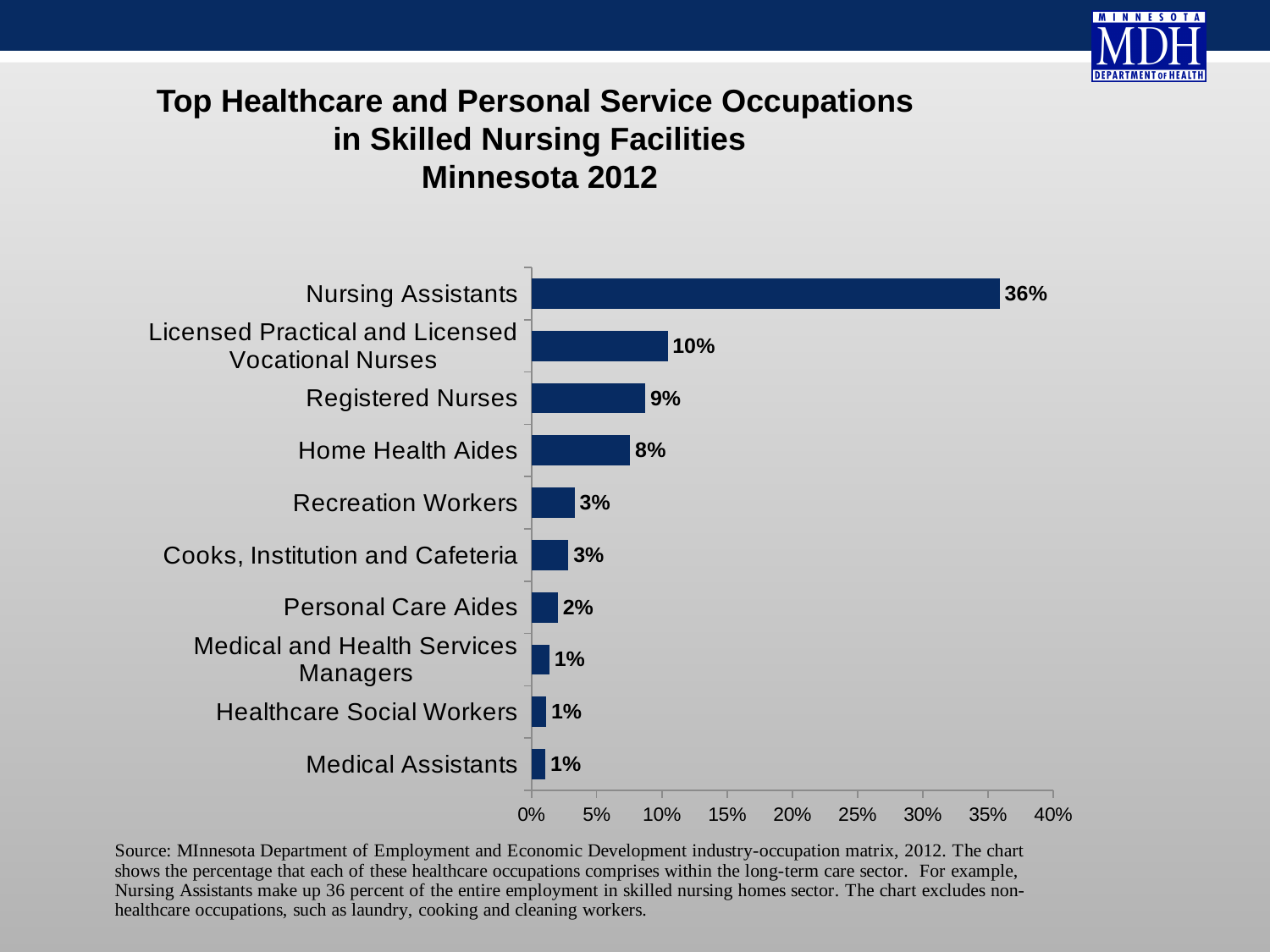
What kind of chart is this? Bar chart Which is larger, the value for Registered Nurses or the value for Home Health Aides? Registered Nurses How many occupations are shown in the chart? 10 What is the value for Home Health Aides? 8% Is the value for Nursing Assistants greater or less than 35%? greater Which occupation has the highest percentage? Nursing Assistants What is the difference between the values for Licensed Practical and Licensed Vocational Nurses and Recreation Workers? 7% What percentage is shown for Licensed Practical and Licensed Vocational Nurses? 10% What is the title of the chart? Top Healthcare and Personal Service Occupations in Skilled Nursing Facilities Minnesota 2012 What percentage is shown for Nursing Assistants? 36% What is the difference between the values for Nursing Assistants and Registered Nurses? 27% What is the value for Personal Care Aides? 2%